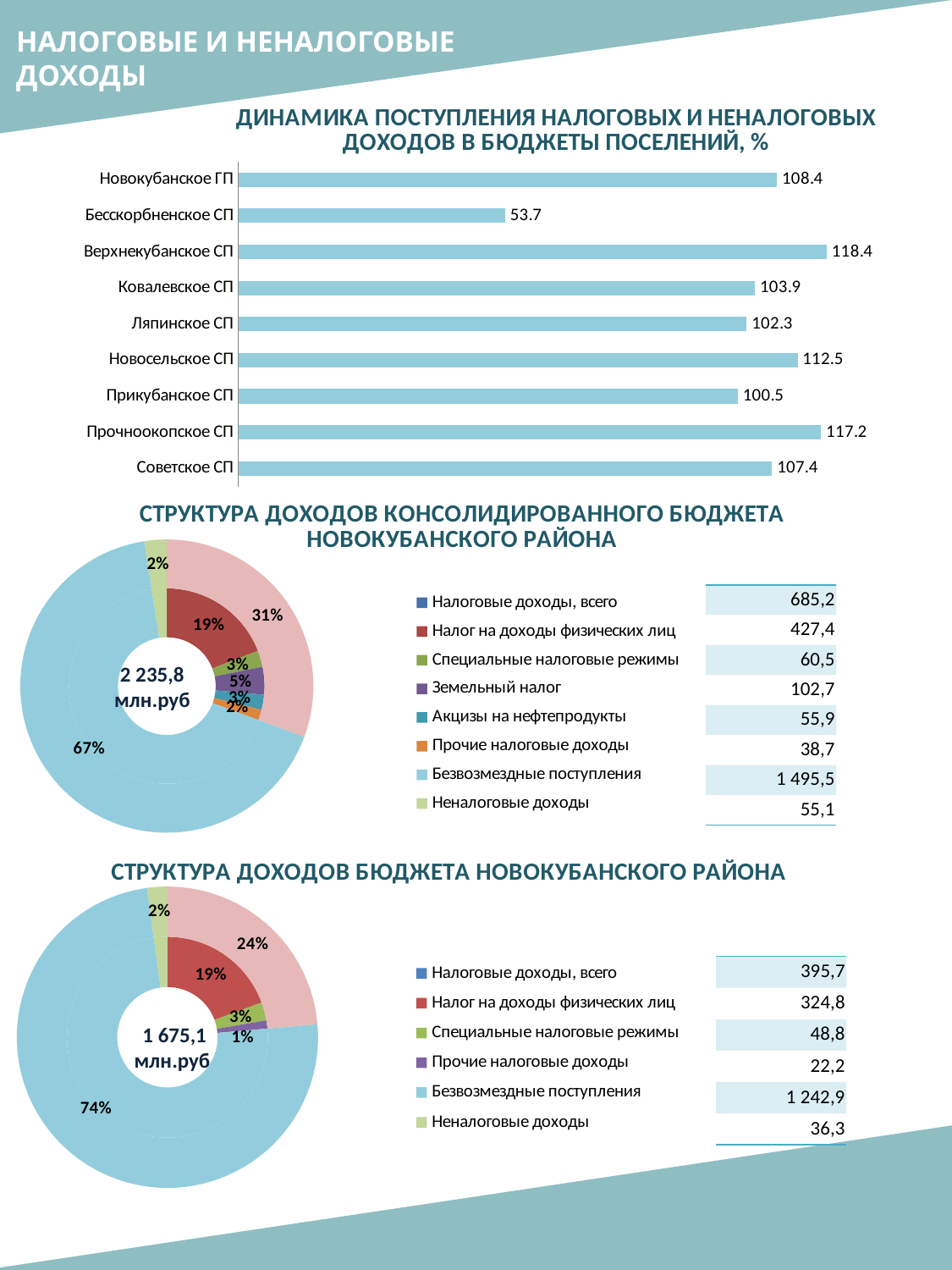
What type of chart is 'Динамика поступления налоговых и неналоговых доходов в бюджеты поселений, %'? Bar chart In the bar chart 'Динамика поступления налоговых и неналоговых доходов в бюджеты поселений, %', what is the value for Верхнекубанское СП? 118.4 In the chart 'Структура доходов бюджета Новокубанского района', what share does Безвозмездные поступления have? 74% In the chart 'Структура доходов консолидированного бюджета Новокубанского района', what total is shown in the centre of the doughnut? 2 235,8 млн.руб In the bar chart 'Динамика поступления налоговых и неналоговых доходов в бюджеты поселений, %', how many settlements are shown? 9 In the bar chart 'Динамика поступления налоговых и неналоговых доходов в бюджеты поселений, %', which is larger: Новосельское СП or Советское СП? Новосельское СП In the chart 'Структура доходов бюджета Новокубанского района', how many entries does the legend list? 6 In the bar chart 'Динамика поступления налоговых и неналоговых доходов в бюджеты поселений, %', which settlement has the lowest value? Бесскорбненское СП In the chart 'Структура доходов консолидированного бюджета Новокубанского района', what share does Безвозмездные поступления have? 67% In the bar chart 'Динамика поступления налоговых и неналоговых доходов в бюджеты поселений, %', what is the difference between Прочноокопское СП and Прикубанское СП? 16.7 In the chart 'Структура доходов консолидированного бюджета Новокубанского района', what is the value for Налог на доходы физических лиц? 427,4 In the bar chart 'Динамика поступления налоговых и неналоговых доходов в бюджеты поселений, %', which settlement has the highest value? Верхнекубанское СП